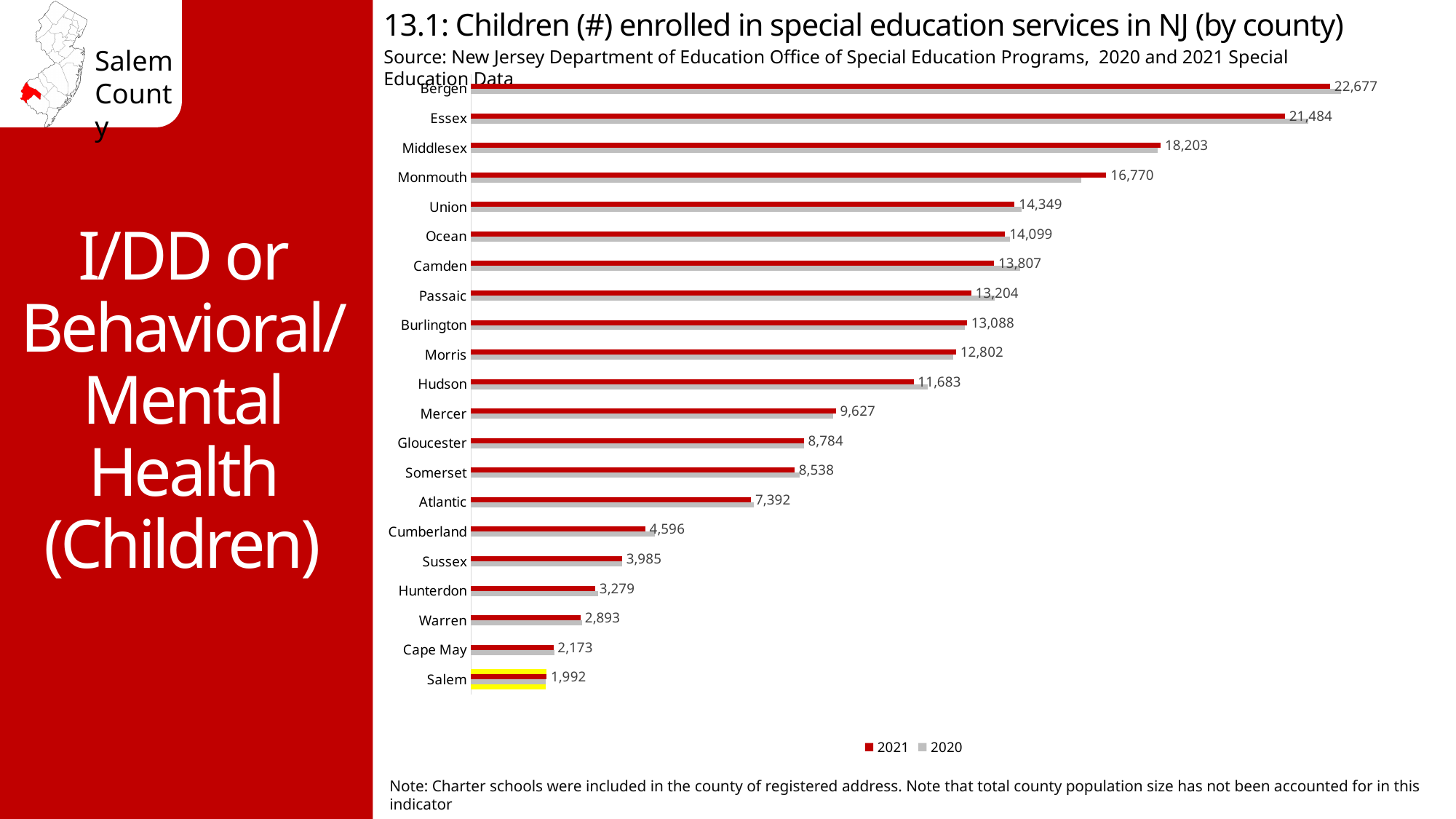
What is the 2021 value labeled for Salem? 1,992 What type of chart is shown on the slide? Bar chart Which county has the lowest number of children enrolled in special education services? Salem What is the difference between the labeled values for Cape May and Salem? 181 How many series does the legend list? 2 Which county has the highest number of children enrolled in special education services? Bergen What is the difference between the labeled values for Bergen and Essex? 1,193 What is the 2021 value labeled for Bergen? 22,677 Which year is represented by the red bars according to the legend? 2021 How many counties are shown in the chart? 21 Which has a larger labeled value, Cumberland or Sussex? Cumberland What is the 2021 value labeled for Gloucester? 8,784